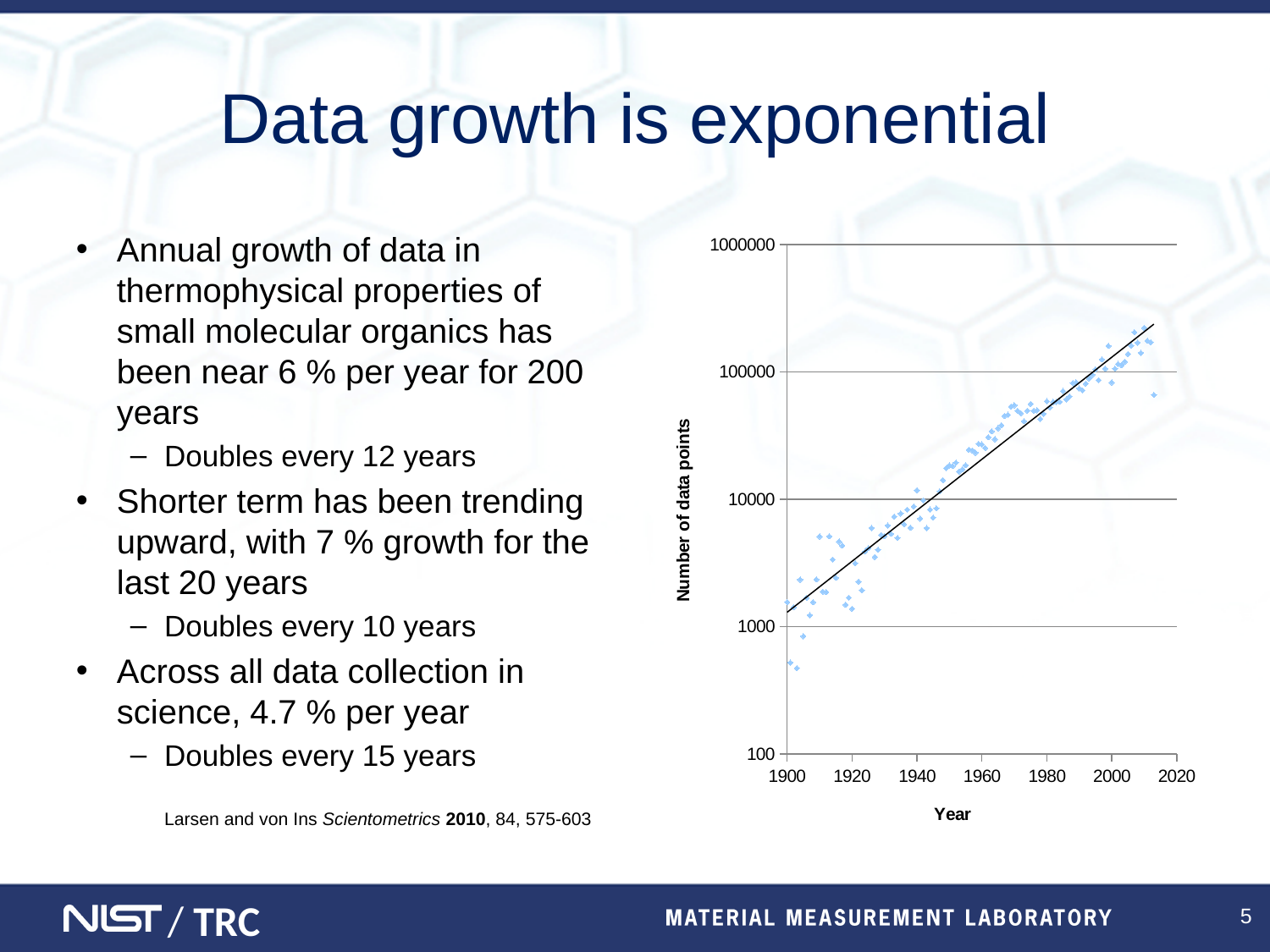
What kind of chart is shown on the slide? scatter chart Which is larger, the number of data points around 1920 or around 2000? around 2000 Is the number of data points around 1920 greater or less than 10000? less What is the label of the horizontal axis of the chart? Year Do the plotted values rise or fall as the year increases along the x axis? rise Is the number of data points around 2010 greater or less than 100000? greater What is the label of the vertical axis of the chart? Number of data points Is the number of data points around 1980 greater or less than 100000? less